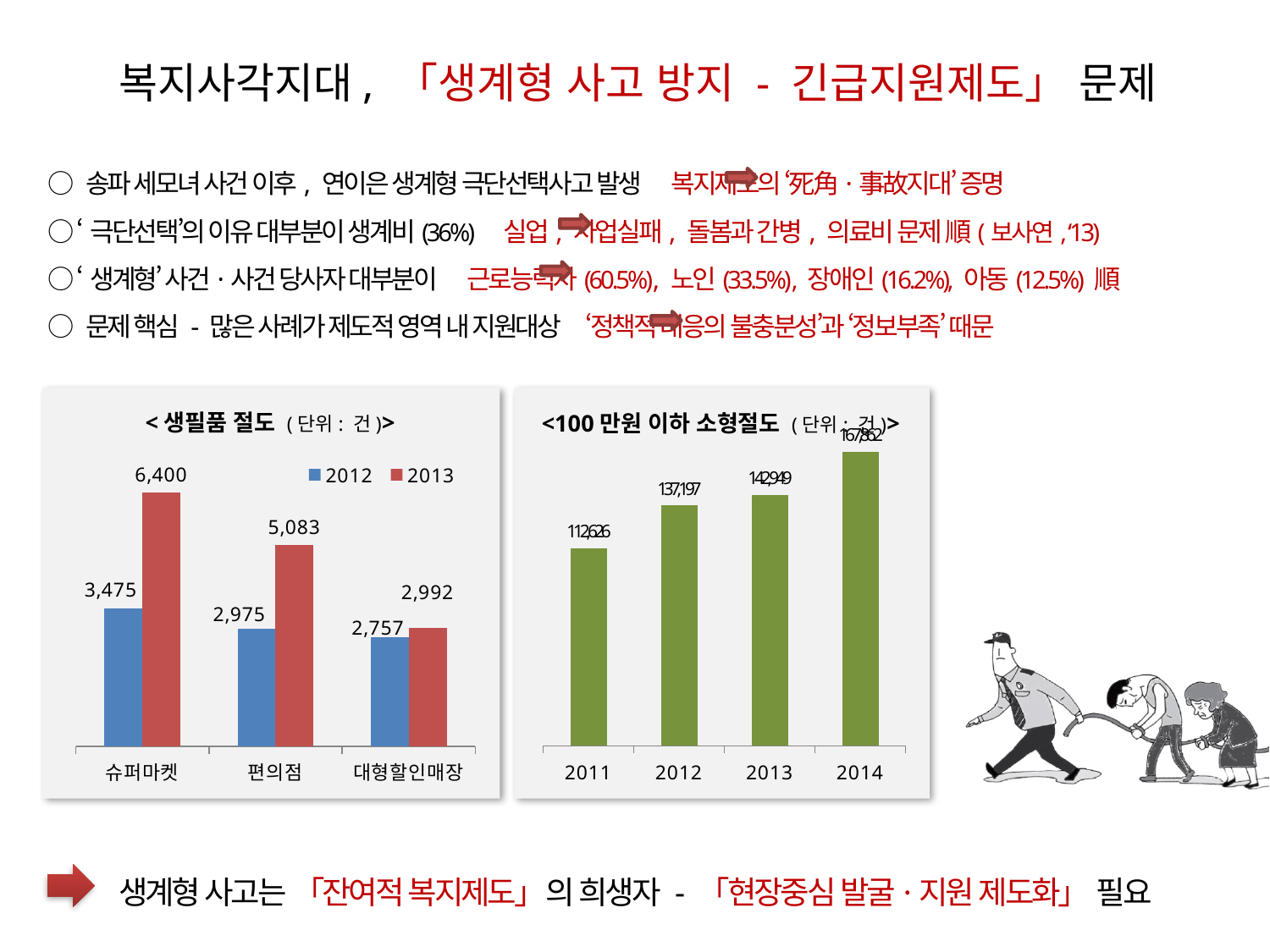
In the 생필품 절도 chart, which category has the lowest 2012 value? 대형할인매장 In the 100만원 이하 소형절도 chart, do the values rise or fall from 2011 to 2014? Rise In the 100만원 이하 소형절도 chart, what is the value for 2011? 112,626 In the 생필품 절도 chart, which colour represents 2013? Red In the 100만원 이하 소형절도 chart, what is the value for 2012? 137,197 In the 생필품 절도 chart, what is the 2013 value for 대형할인매장? 2,992 In the 생필품 절도 chart, what is the 2013 value for 슈퍼마켓? 6,400 In the 생필품 절도 chart, what is the difference between the 2013 and 2012 values for 슈퍼마켓? 2,925 In the 100만원 이하 소형절도 chart, how many years are shown? 4 In the 생필품 절도 chart, which category has the highest 2013 value? 슈퍼마켓 In the 생필품 절도 chart, what is the 2012 value for 편의점? 2,975 In the 생필품 절도 chart, how many series does the legend list? 2